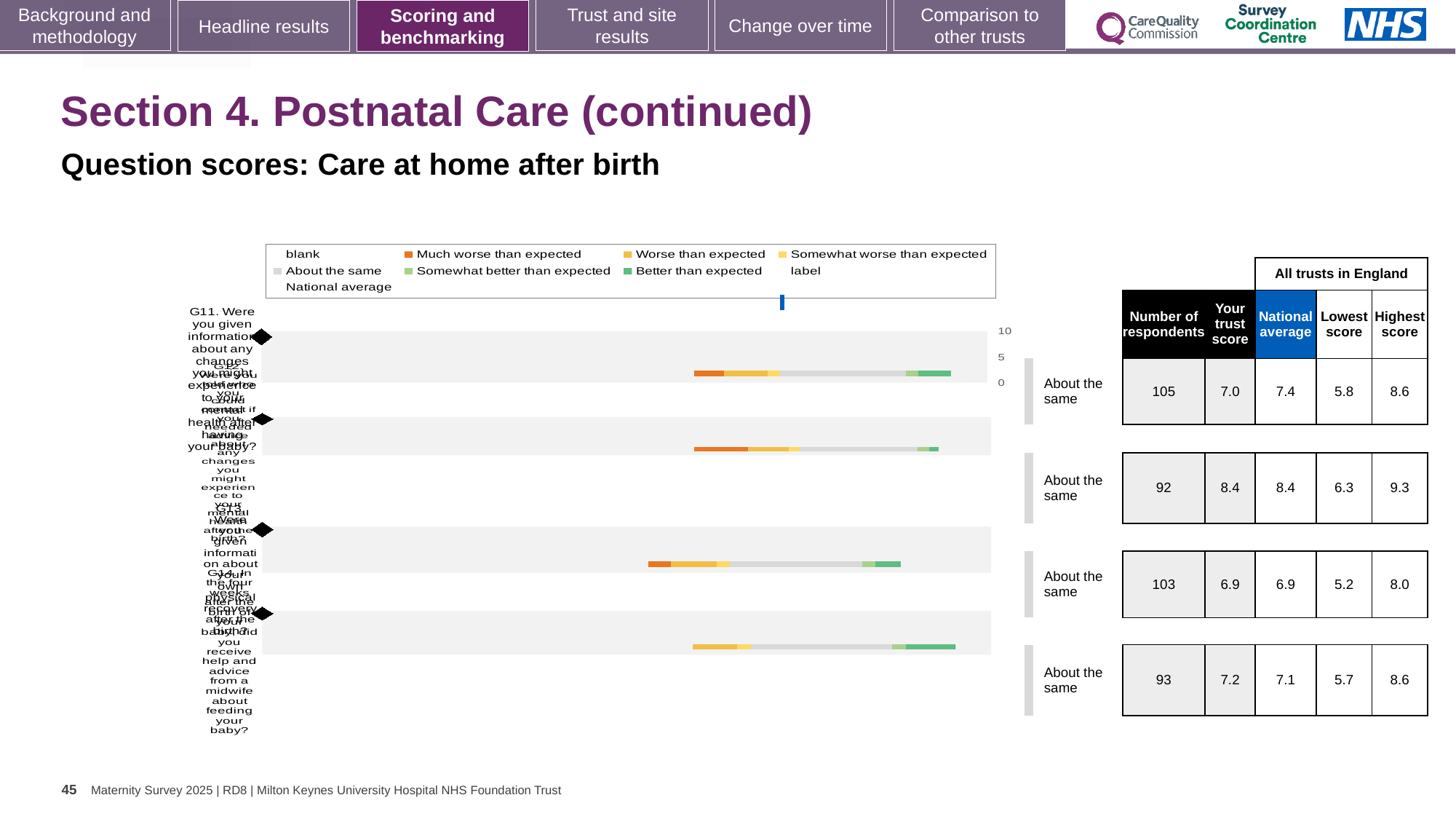
How many horizontal bars are plotted in the chart? 4 What is the highest tick value shown on the chart's axis? 10 In the table next to the chart, is the trust score in the second row larger or smaller than the trust score in the first row? larger In the chart legend, what does the vertical blue line represent? National average In the chart legend, what colour is used for 'Much worse than expected'? orange In the table next to the chart, what is the number of respondents in the first row? 105 What kind of chart is shown on the slide? bar chart In the table next to the chart, what is the national average in the third row? 6.9 In the table next to the chart, which row has the highest 'Highest score' value? the second row (9.3) In the table next to the chart, what is the 'Your trust score' value in the second row? 8.4 In the table next to the chart, what is the difference between the highest score and the lowest score in the first row? 2.8 What benchmark label is shown beside each of the four bars? About the same